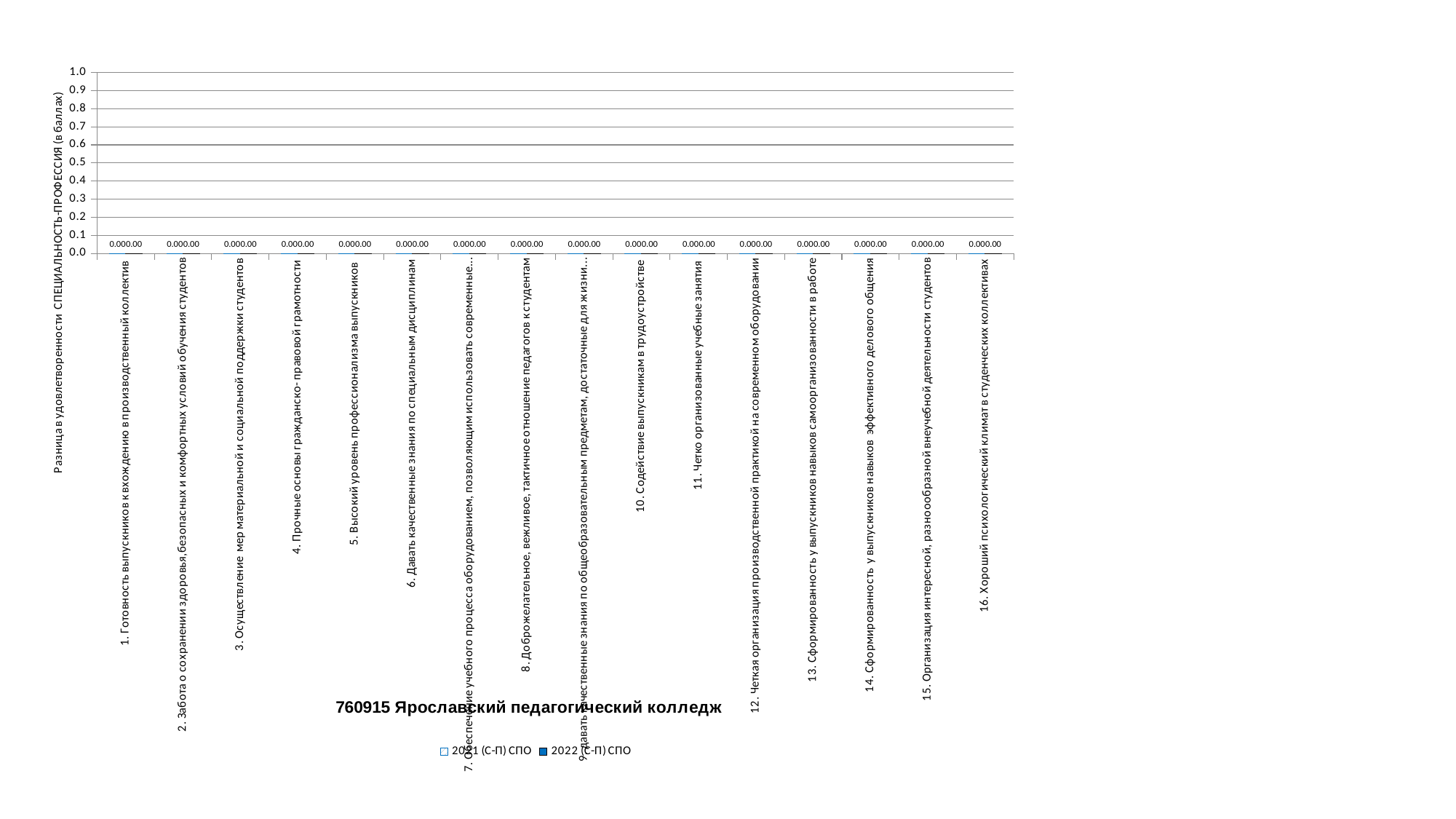
What data label is printed above category "1. Готовность выпускников к вхождению в производственный коллектив"? 0.000.00 What is the highest tick value shown on the y axis? 1.0 What kind of chart is shown on the slide? bar chart What is the title of the chart? 760915 Ярославский педагогический колледж How many categories are shown along the x axis of the chart? 16 What data label is printed above category "10. Содействие выпускникам в трудоустройстве"? 0.000.00 What are the two series named in the chart legend? 2021 (С-П) СПО and 2022 (С-П) СПО What data label is printed above category "16. Хороший психологический климат в студенческих коллективах"? 0.000.00 Is the value for "12. Четкая организация производственной практикой на современном оборудовании" greater or less than 0.1? less Is the value for "5. Высокий уровень профессионализма выпускников" greater or less than 0.5? less Do the values rise, fall, or stay flat across the categories along the x axis? stay flat How many series does the chart legend list? 2